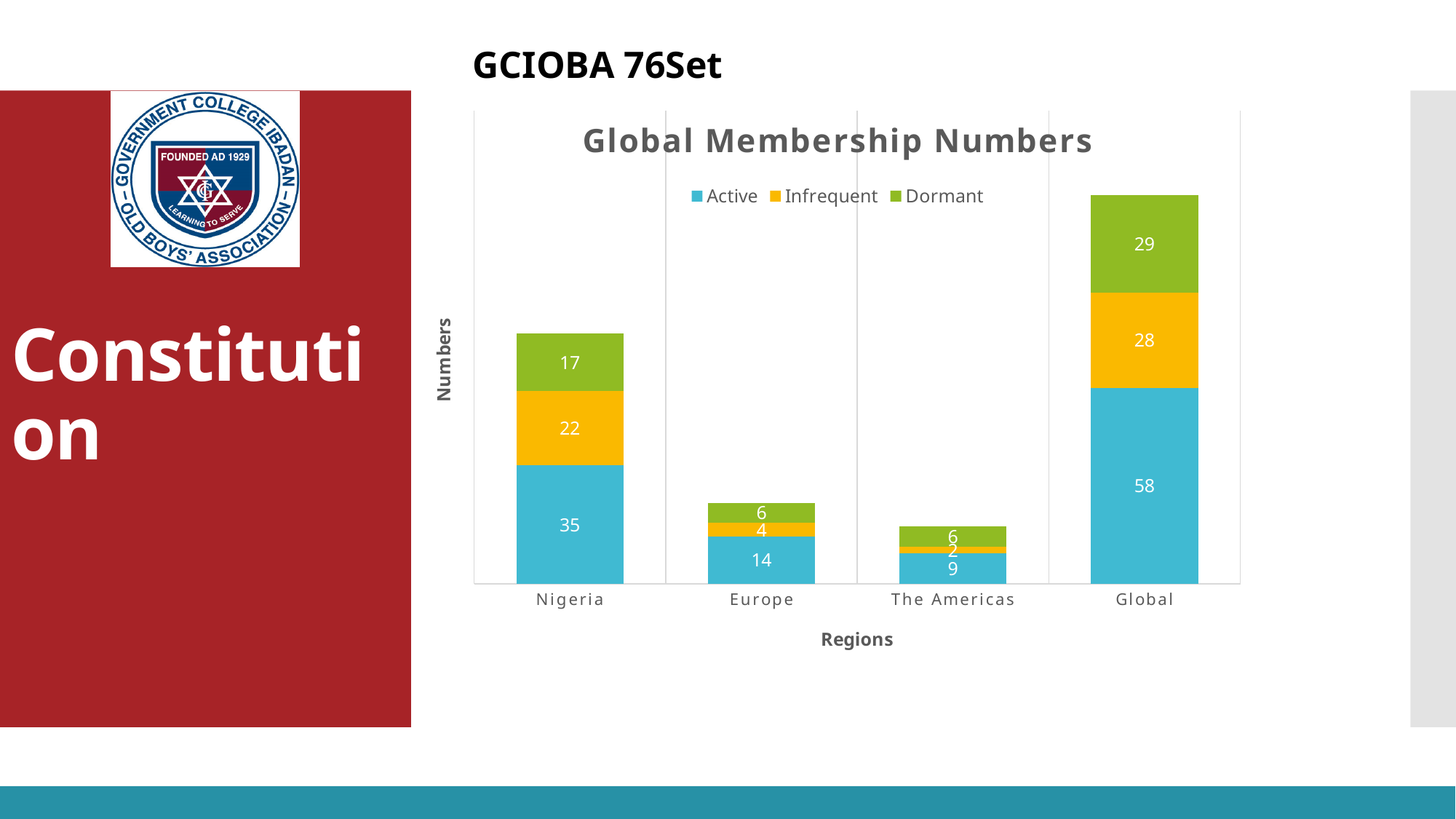
How many series does the legend list? 3 What is the difference between the Active membership numbers for Global and Nigeria? 23 What is the Active membership number for The Americas? 9 What is the total membership number for the Europe bar? 24 Which region has the lowest Infrequent membership number? The Americas Which is larger, the Dormant number for Nigeria or the Dormant number for Europe? Nigeria What is the Dormant membership number for Global? 29 How many regions are shown on the x axis? 4 What is the total membership number for the Nigeria bar? 74 What is the Active membership number for Nigeria? 35 What is the Infrequent membership number for Europe? 4 Which region has the highest Active membership number? Global